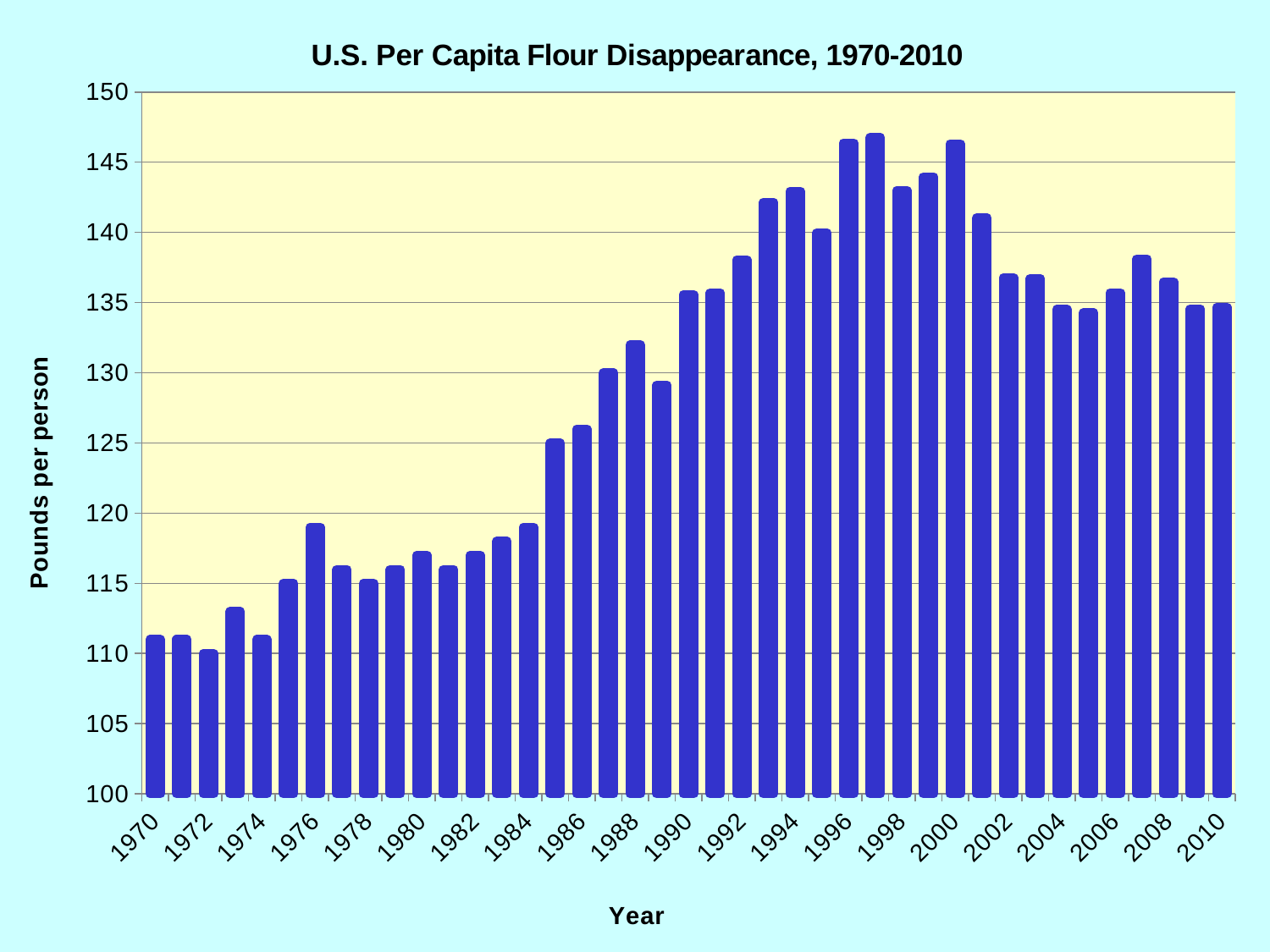
Which year has the larger value, 2008 or 2004? 2008 Which year has the larger value, 1988 or 1984? 1988 Which year has the lowest value in the chart? 1972 Is the value for 1986 greater or less than 125? greater Do the values generally rise or fall from 1984 to 1996? rise What is the title of the chart? U.S. Per Capita Flour Disappearance, 1970-2010 Is the value for 1970 greater or less than 115? less Is the value for 1996 greater or less than 145? greater What is the label on the vertical axis of the chart? Pounds per person What kind of chart is shown on the slide? Bar chart How many bars (years) are plotted in the chart? 41